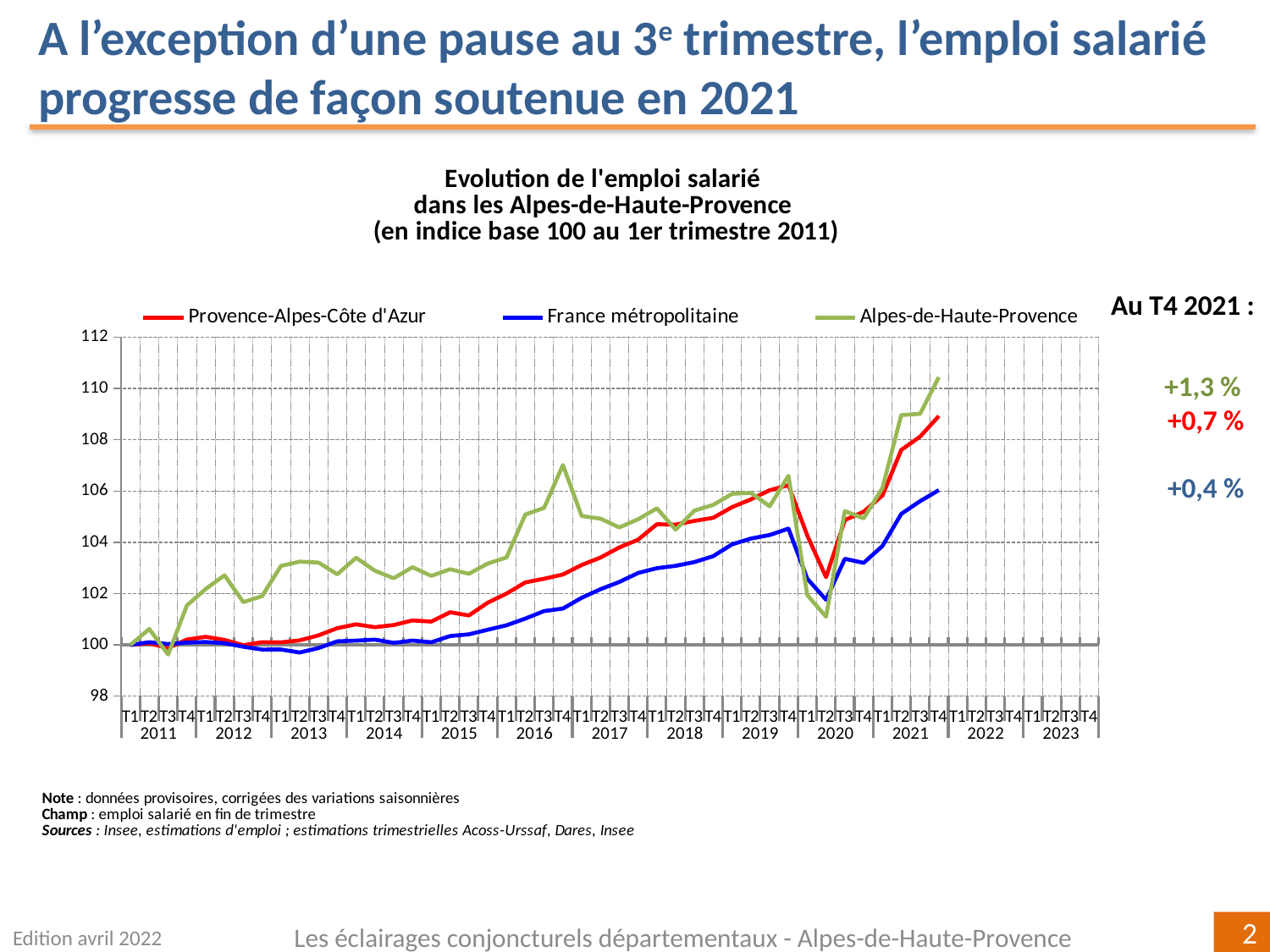
At T4 2016, which is higher: Alpes-de-Haute-Provence or Provence-Alpes-Côte d'Azur? Alpes-de-Haute-Provence What growth rate is shown for Alpes-de-Haute-Provence at T4 2021? +1,3 % What growth rate is shown for France métropolitaine at T4 2021? +0,4 % How many series does the legend list? 3 Is the value for Alpes-de-Haute-Provence at T2 2020 greater or less than 102? less What is the index value of all three series at T1 2011? 100 Which series has the highest index value at T4 2021? Alpes-de-Haute-Provence Is the value for Alpes-de-Haute-Provence at T4 2021 greater or less than 108? greater Which series has the lowest index value at T4 2021? France métropolitaine What growth rate is shown for Provence-Alpes-Côte d'Azur at T4 2021? +0,7 % What type of chart is shown on the slide? line chart Which series is shown in green in the legend? Alpes-de-Haute-Provence